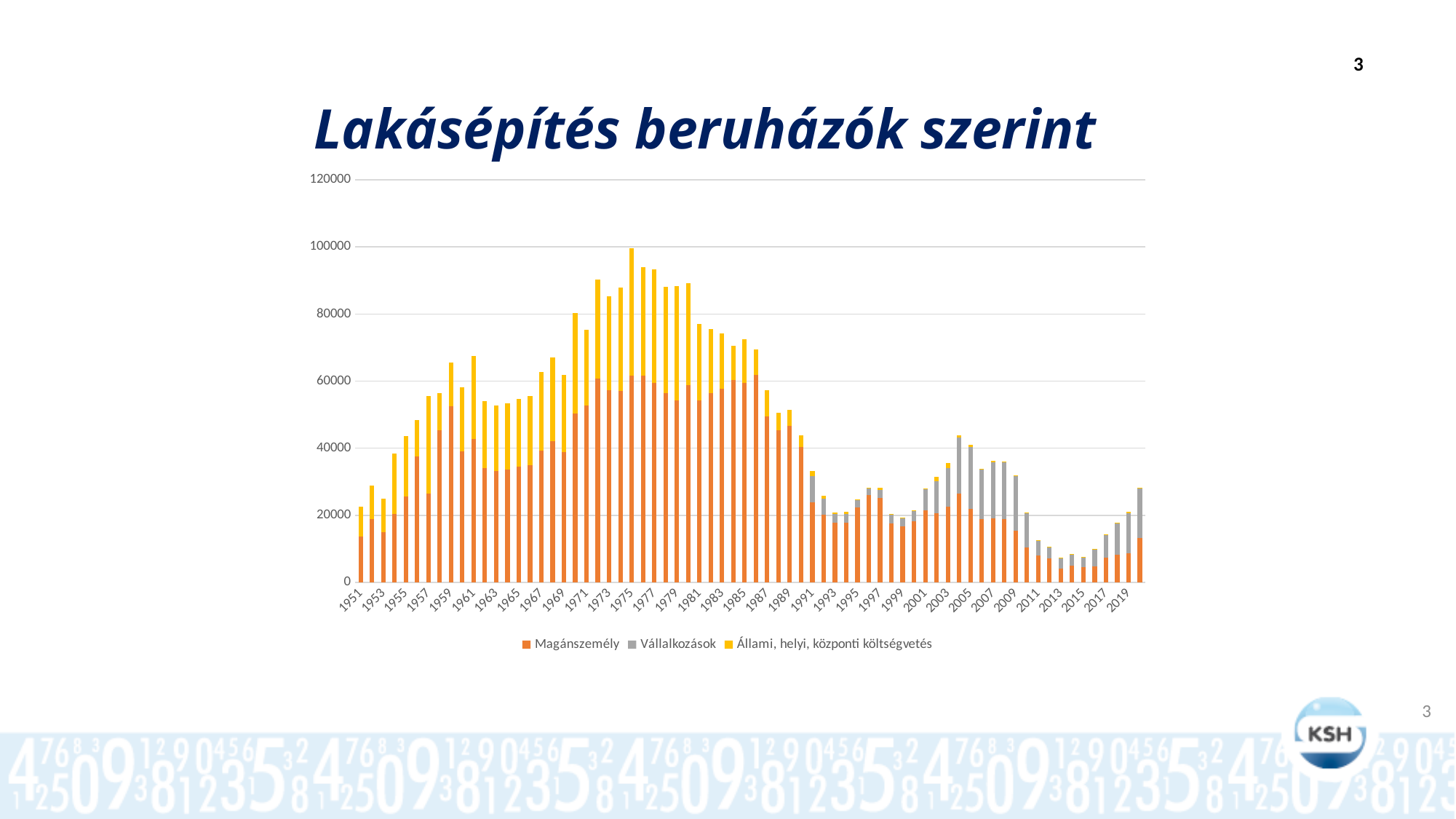
Which year has the larger total bar, 1951 or 1959? 1959 Which series is shown in orange in the legend? Magánszemély Is the total value for 1991 greater or less than 60000? less What kind of chart is shown on the slide? stacked bar chart Is the total value for 1975 greater or less than 80000? greater Which year has the tallest stacked bar? 1975 What is the title of the chart? Lakásépítés beruházók szerint Is the total value for 2013 greater or less than 20000? less Which year has the larger total bar, 1975 or 2005? 1975 How many series does the legend list? 3 Do the total values generally rise or fall from 1975 to 1990? fall